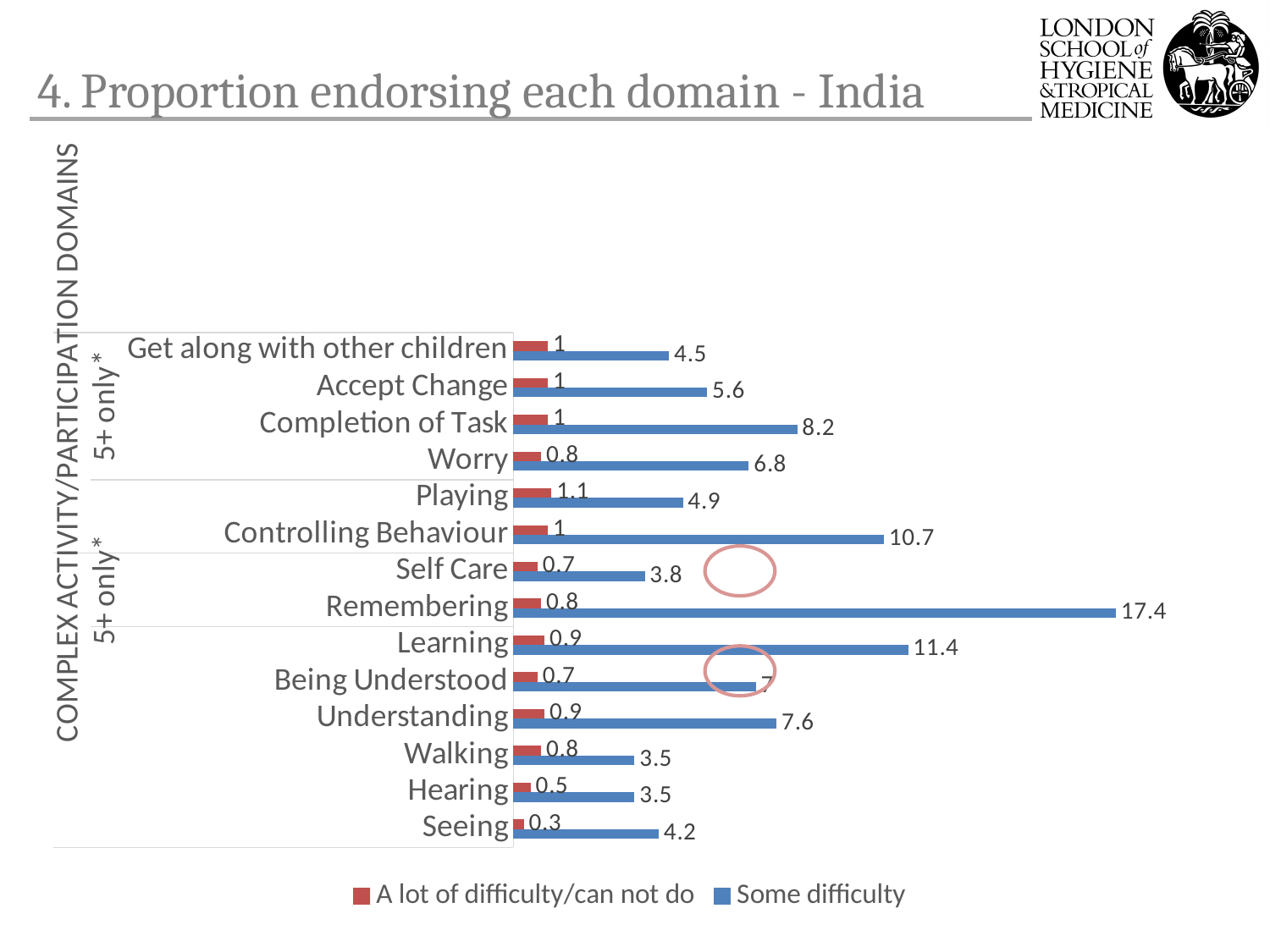
What is the 'Some difficulty' value for Remembering? 17.4 Which series is shown in blue in the legend? Some difficulty What is the 'Some difficulty' value for Controlling Behaviour? 10.7 Which domain has the highest 'Some difficulty' value? Remembering Which domain has the lowest 'A lot of difficulty/can not do' value? Seeing What is the difference between the 'Some difficulty' values for Learning and Completion of Task? 3.2 How many series does the legend list? 2 Which has a larger 'Some difficulty' value, Worry or Accept Change? Worry How many domains are shown on the chart? 14 What is the 'A lot of difficulty/can not do' value for Seeing? 0.3 What kind of chart is shown on the slide? Bar chart Which domain has the highest 'A lot of difficulty/can not do' value? Playing